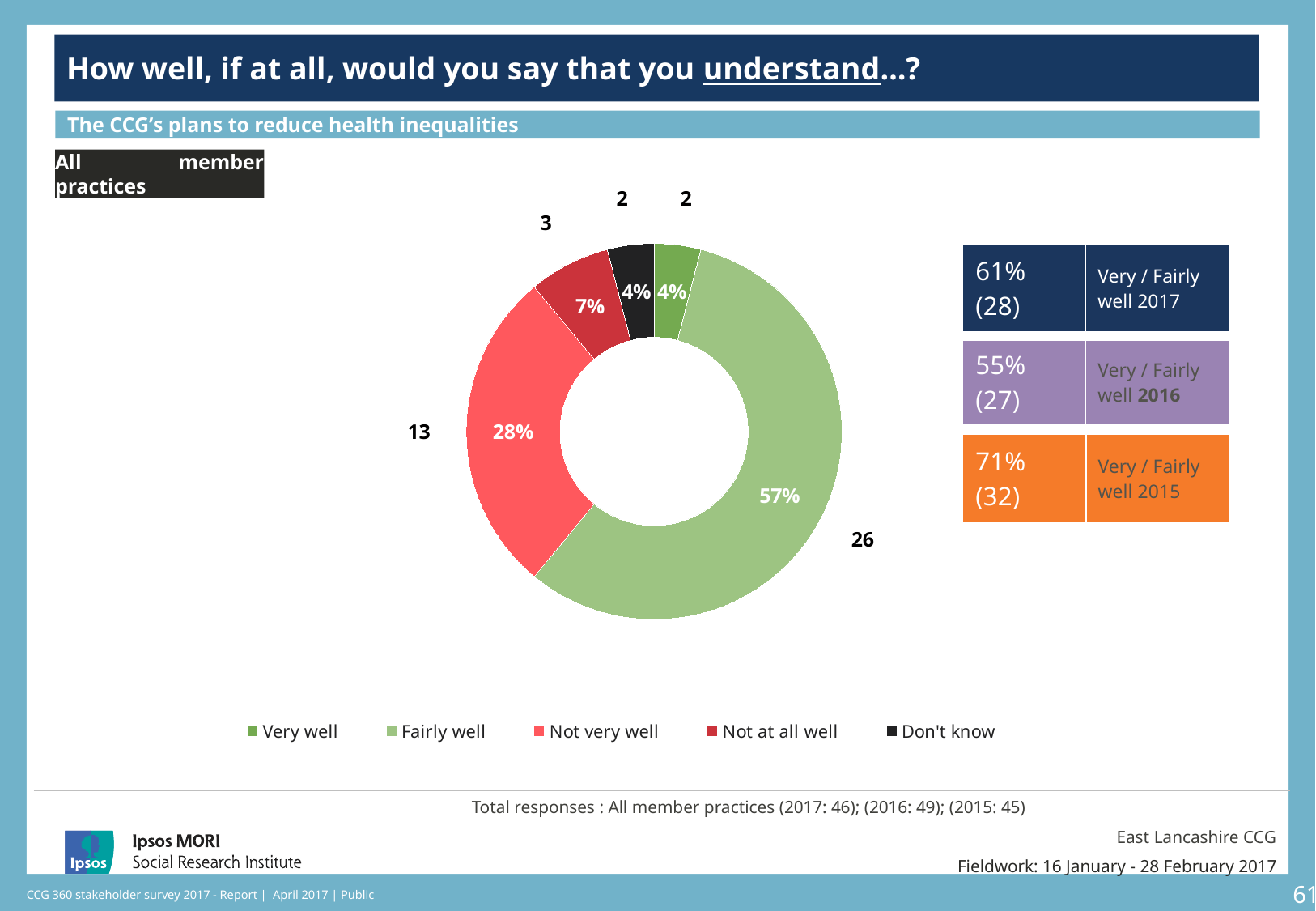
What kind of chart is shown on the slide? Donut (pie) chart What percentage of respondents answered 'Don't know'? 4% How many response categories does the legend list? 5 Which response category has the largest share of the donut chart? Fairly well What was the 'Very / Fairly well' percentage in 2015? 71% What percentage of respondents answered 'Not very well'? 28% What is the combined 'Very / Fairly well' percentage for 2017 shown in the box to the right of the chart? 61% What percentage of respondents said they understand the CCG's plans to reduce health inequalities 'Fairly well'? 57% What colour represents 'Don't know' in the chart? Black How many respondents answered 'Not at all well'? 3 Which is larger: the share for 'Not very well' or the share for 'Not at all well'? Not very well What is the difference in percentage points between 'Fairly well' and 'Not very well'? 29